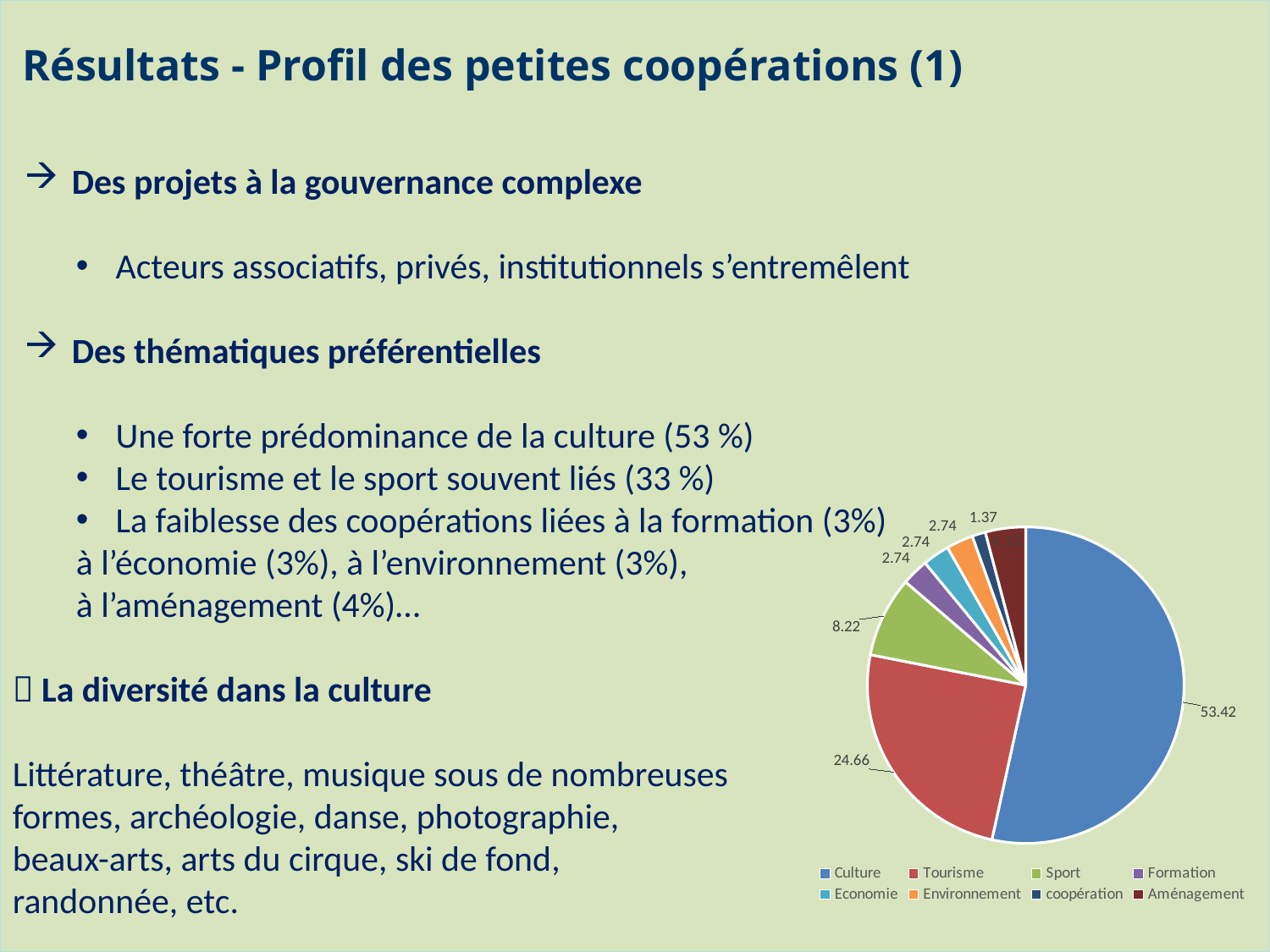
What is the value shown for Sport in the pie chart? 8.22 What is the value shown for Tourisme in the pie chart? 24.66 What is the value shown for Formation in the pie chart? 2.74 Which category has the smallest slice in the pie chart? coopération What colour is the Culture slice in the pie chart? blue What is the value shown for coopération in the pie chart? 1.37 What is the difference between the values for Culture and Tourisme in the pie chart? 28.76 What is the value shown for Culture in the pie chart? 53.42 How many categories does the legend of the pie chart list? 8 Which category has the largest slice in the pie chart? Culture What kind of chart is shown on the slide? pie chart Which is larger in the pie chart, Tourisme or Sport? Tourisme